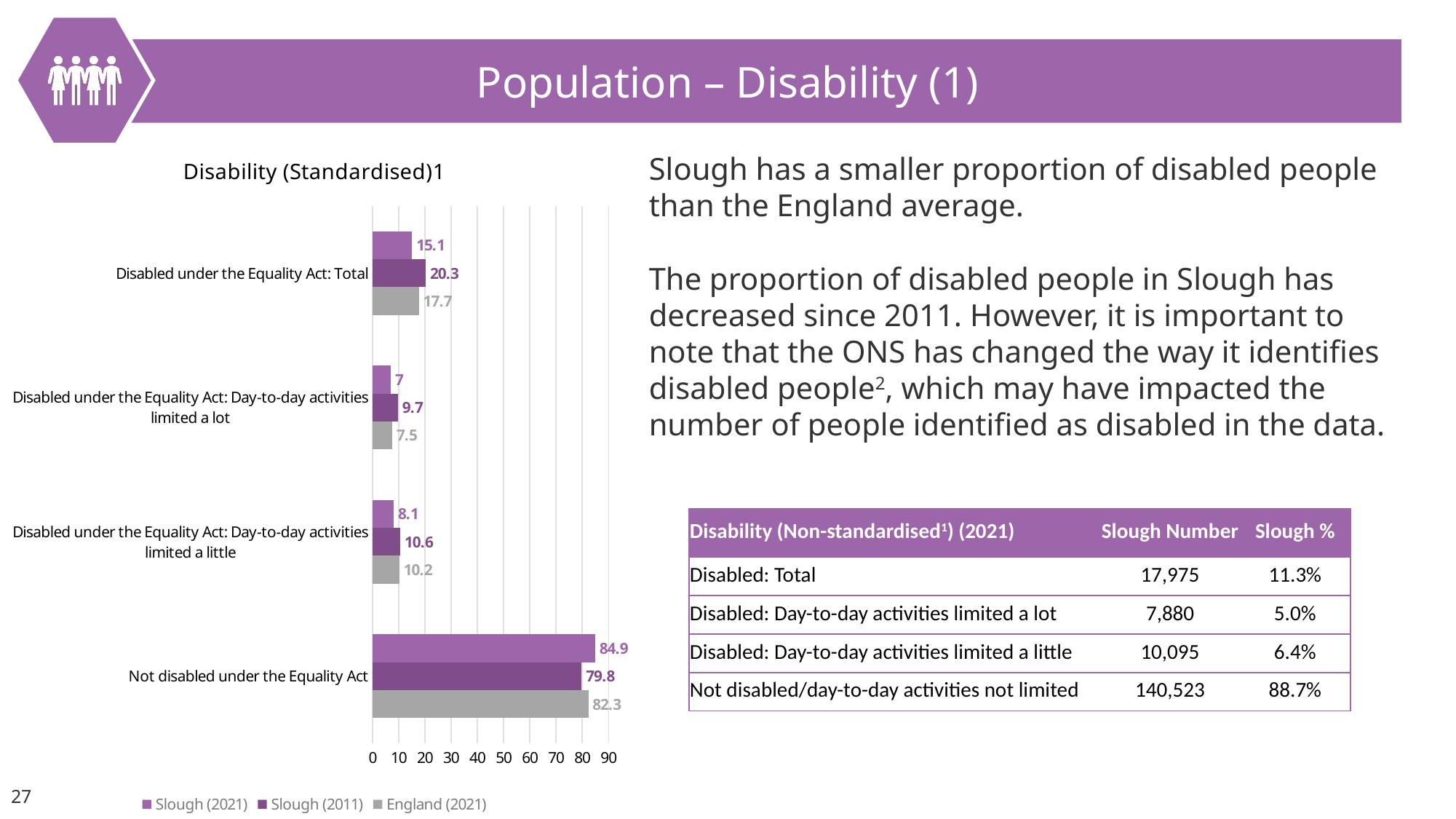
What is the Slough (2011) value for 'Not disabled under the Equality Act'? 79.8 What is the England (2021) value for 'Disabled under the Equality Act: Day-to-day activities limited a lot'? 7.5 How many series does the chart legend list? 3 What is the Slough (2021) value for 'Disabled under the Equality Act: Total'? 15.1 Is the England (2021) value for 'Not disabled under the Equality Act' greater or less than 80? greater How many categories are shown on the chart? 4 Which category has the lowest Slough (2021) value? Disabled under the Equality Act: Day-to-day activities limited a lot What is the Slough (2011) value for 'Disabled under the Equality Act: Day-to-day activities limited a little'? 10.6 What is the difference between the Slough (2011) and Slough (2021) values for 'Disabled under the Equality Act: Total'? 5.2 For 'Not disabled under the Equality Act', which is larger: the Slough (2021) value or the England (2021) value? Slough (2021) What type of chart is shown on the slide? Bar chart Which category has the highest Slough (2021) value? Not disabled under the Equality Act